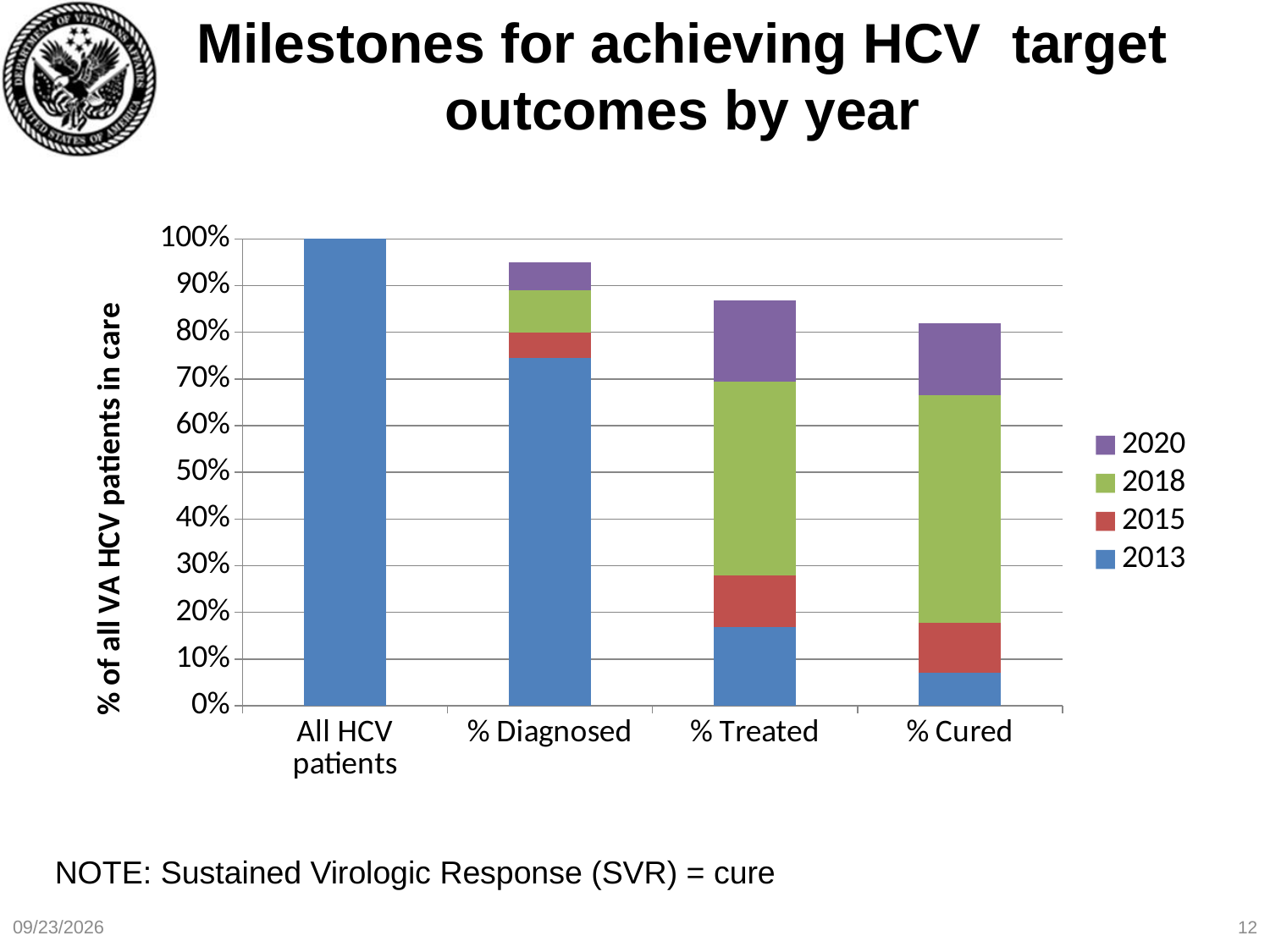
Which category has the tallest stacked bar? All HCV patients How many series does the chart legend list? 4 Which category has the shortest stacked bar? % Cured What is the value of the 2013 bar for All HCV patients? 100% How many categories are shown on the x axis of the chart? 4 Is the total stacked bar for % Diagnosed taller or shorter than the total stacked bar for % Treated? Taller Is the 2013 segment for % Diagnosed greater or less than 70%? greater Which year does the purple colour in the legend represent? 2020 What kind of chart is shown on the slide? Stacked bar chart Is the total stacked bar for % Treated greater or less than 80%? greater What is the title of the y axis? % of all VA HCV patients in care Is the 2013 segment for % Cured greater or less than 10%? less